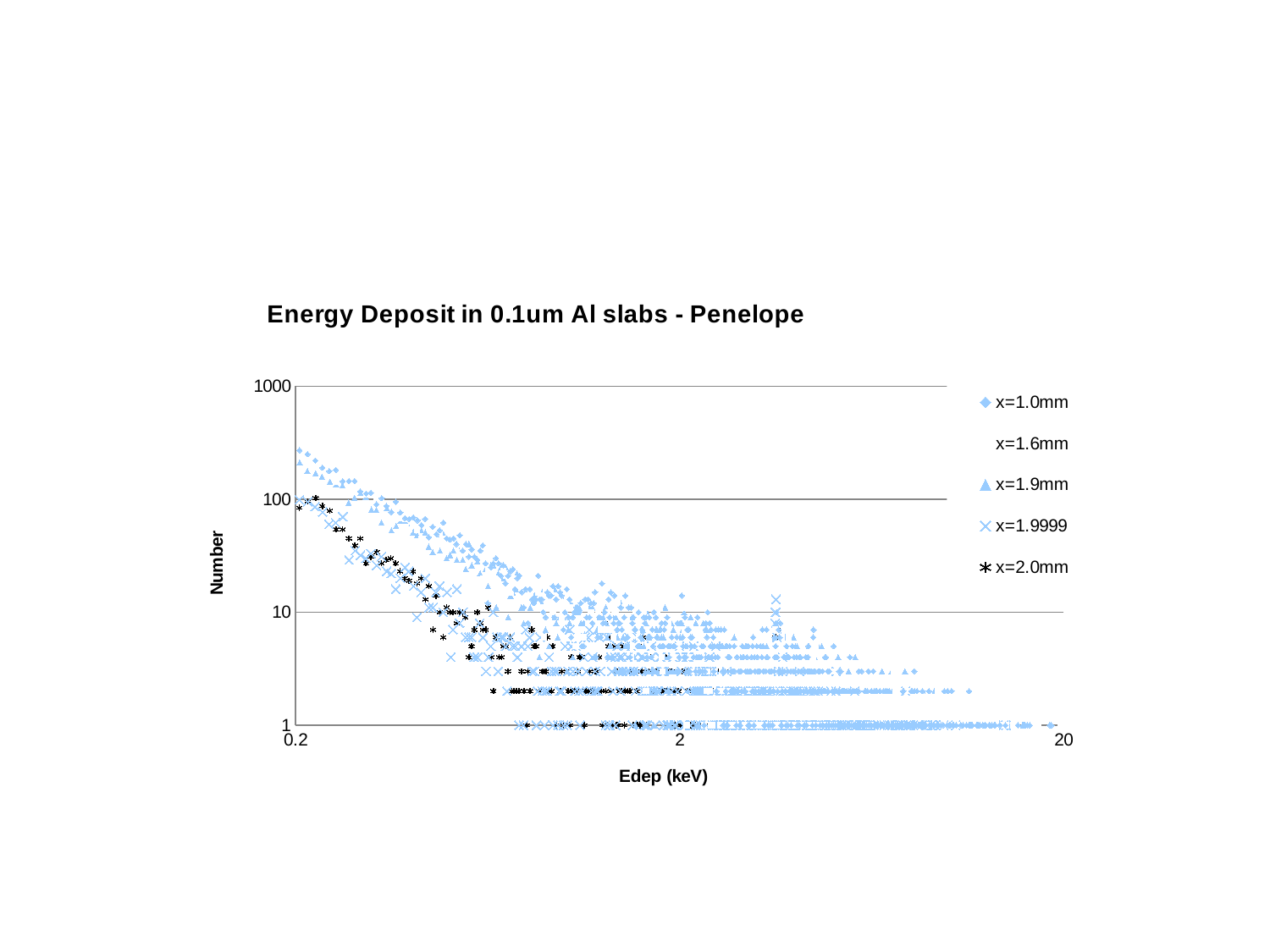
Is the highest Number value for the x=2.0mm series greater or less than 1000? less Is the highest Number value for the x=1.9999 series greater or less than 1000? less Which series has the higher maximum Number value, x=1.0mm or x=2.0mm? x=1.0mm What is the title of the chart? Energy Deposit in 0.1um Al slabs - Penelope What is the label of the x axis? Edep (keV) Is the highest Number value for the x=1.0mm series greater or less than 100? greater What kind of chart is shown on the slide? scatter chart How many series does the legend list? 5 Do the Number values rise or fall as Edep (keV) increases along the x axis? fall